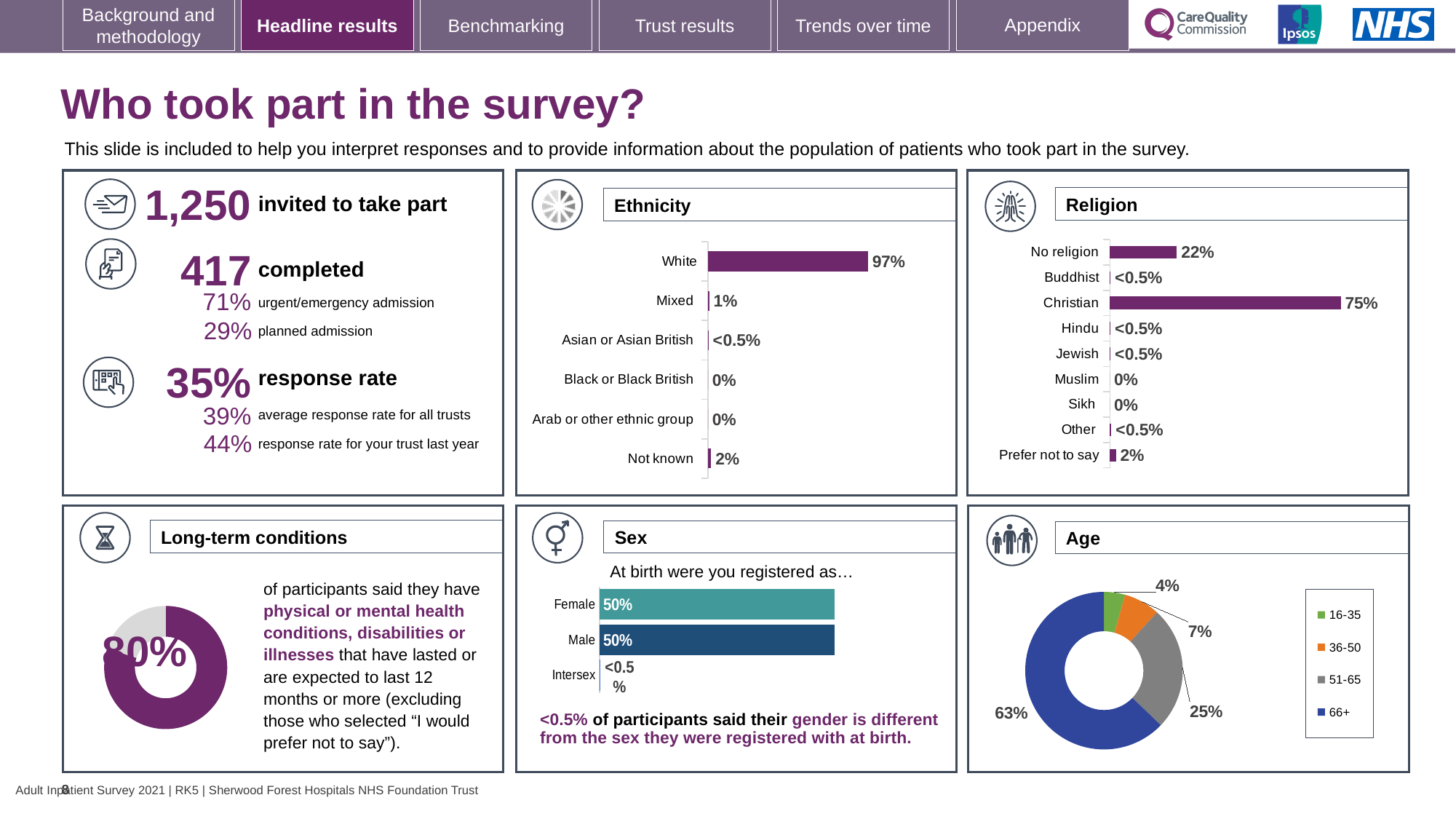
In the Ethnicity chart, how many ethnic categories are plotted? 6 In the Religion chart, what is the value for Prefer not to say? 2% How many age groups does the legend of the Age chart list? 4 In the Sex chart, what percentage of participants were registered as Female at birth? 50% In the Religion chart, which category has the highest value? Christian In the Religion chart, what is the difference between the Christian and No religion values? 53% What kind of chart is the Sex chart? Bar chart In the Age chart, what share of participants were aged 66+? 63% In the Age chart, which age group has the smallest share? 16-35 In the Ethnicity chart, what percentage of participants were White? 97% In the Ethnicity chart, what is the value for Not known? 2% In the Religion chart, what percentage of participants were Christian? 75%